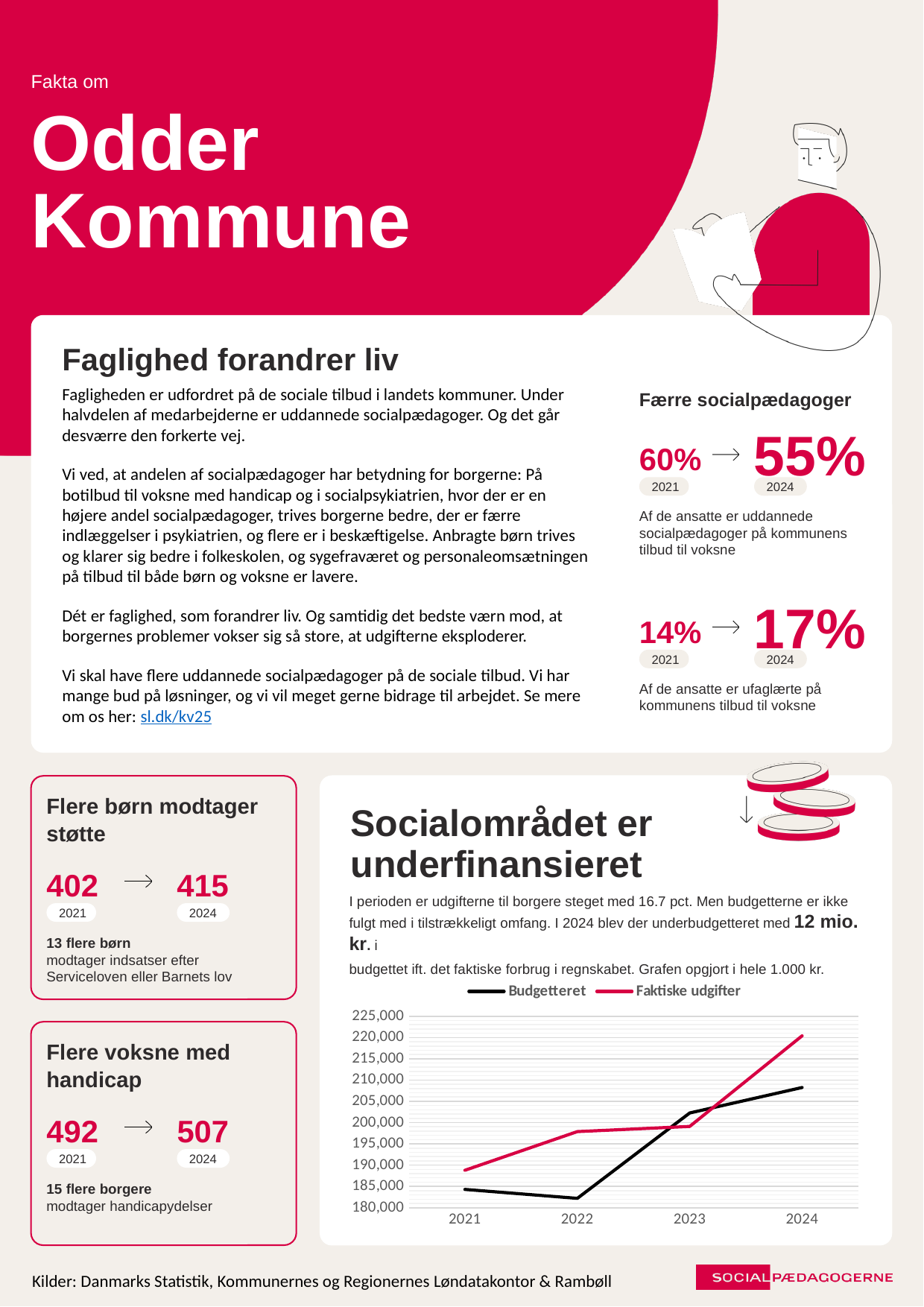
In the line chart, is the value for 'Budgetteret' in 2024 greater or less than 205,000? greater In the line chart, is the value for 'Budgetteret' in 2022 greater or less than 185,000? less How many series does the legend of the line chart list? 2 In the line chart, is the value for 'Faktiske udgifter' in 2024 greater or less than 215,000? greater How many years are plotted along the x axis of the line chart? 4 Which colour is used for the 'Faktiske udgifter' line in the chart? red In the line chart, which series has the higher value in 2024, 'Budgetteret' or 'Faktiske udgifter'? Faktiske udgifter In the line chart, in which year does 'Faktiske udgifter' reach its highest value? 2024 What kind of chart is shown in the 'Socialområdet er underfinansieret' section? line chart What are the two series named in the line chart's legend? Budgetteret and Faktiske udgifter In the line chart, does 'Faktiske udgifter' generally rise or fall from 2021 to 2024? rise In the line chart, which series has the higher value in 2022, 'Budgetteret' or 'Faktiske udgifter'? Faktiske udgifter